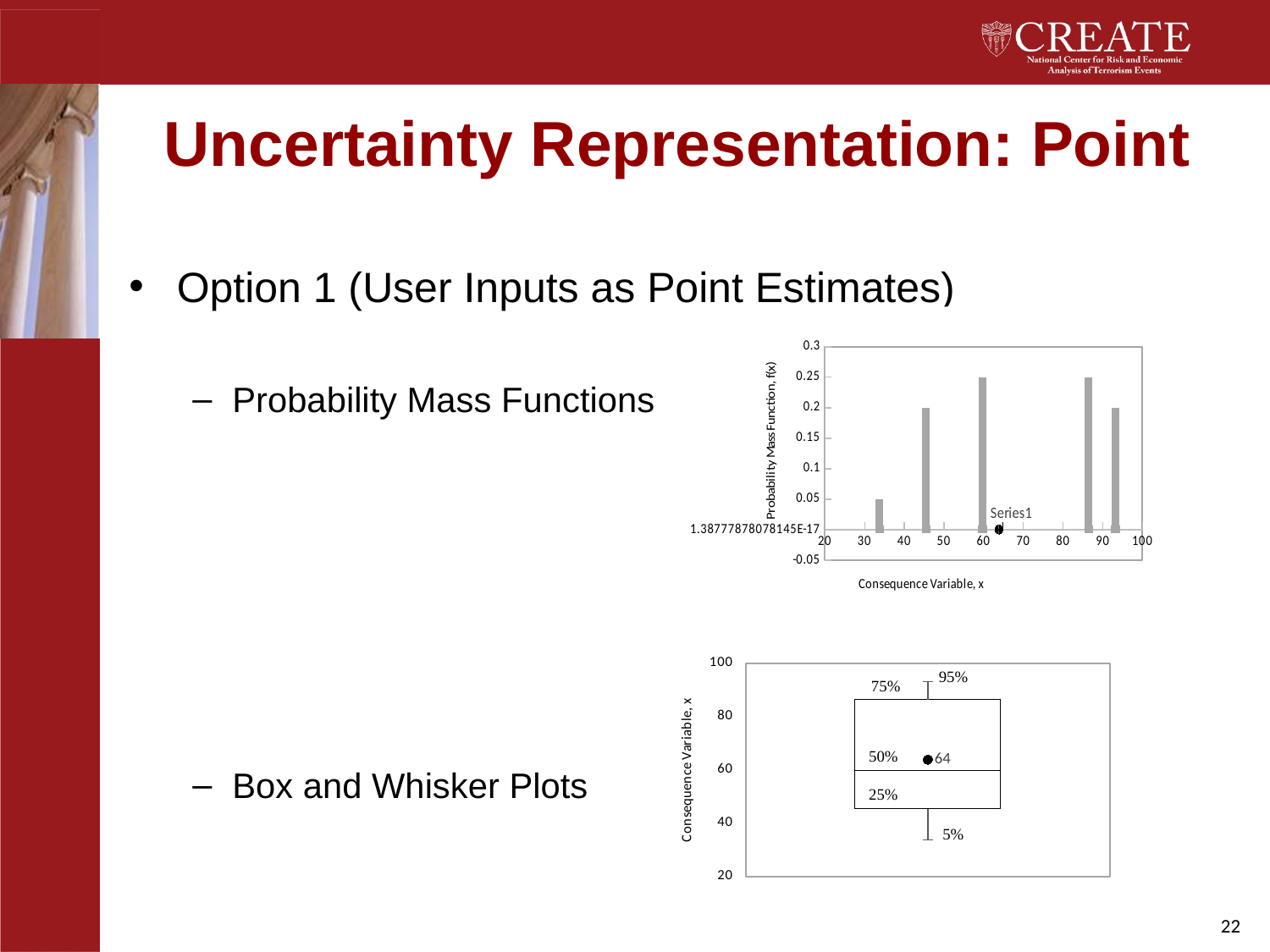
In the bottom chart (Box and Whisker Plot), what percentage label is shown at the top whisker? 95% In the top chart (Probability Mass Function), is the value of the bar near x = 60 greater or less than 0.2? greater In the bottom chart (Box and Whisker Plot), what percentage label is shown at the bottom whisker? 5% What is the y-axis label of the bottom chart (Box and Whisker Plot)? Consequence Variable, x In the bottom chart (Box and Whisker Plot), what value is printed next to the plotted point? 64 In the top chart (Probability Mass Function), is the value of the shortest bar (near x = 34) greater or less than 0.1? less In the bottom chart (Box and Whisker Plot), is the plotted point value greater or less than 60? greater In the top chart (Probability Mass Function), is the bar near x = 45 taller or shorter than the bar near x = 34? taller What is the y-axis label of the top chart on the slide? Probability Mass Function, f(x) In the bottom chart (Box and Whisker Plot), what percentage label is shown at the line inside the box where the point is plotted? 50% In the top chart (Probability Mass Function), how many bars are plotted? 5 What kind of chart is the top chart on the slide (the Probability Mass Function chart)? bar chart